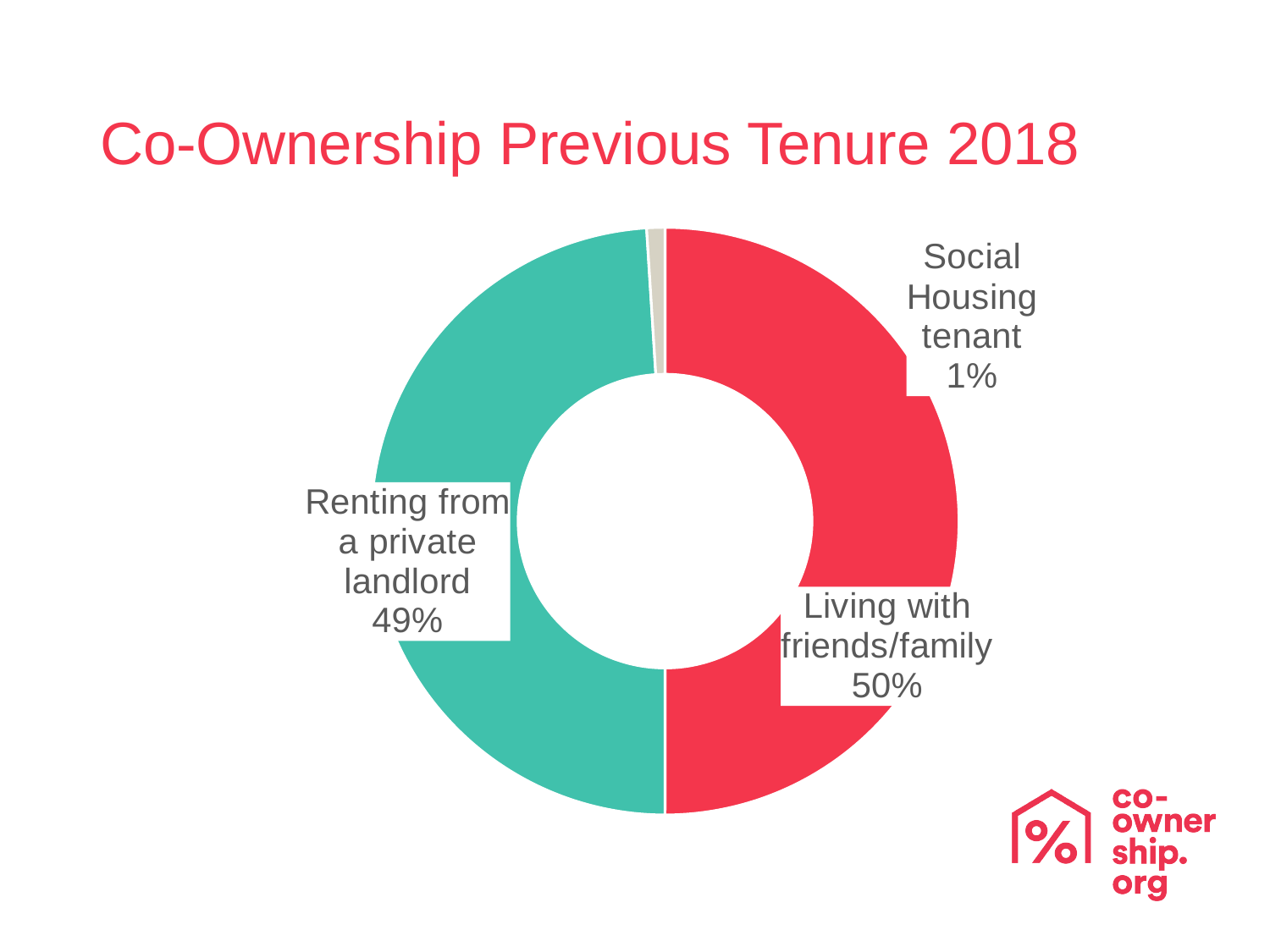
Which category has the smallest share? Social Housing tenant How many categories are shown in the chart? 3 What is the difference between the shares for 'Living with friends/family' and 'Renting from a private landlord'? 1% What share of the chart is 'Living with friends/family'? 50% What is the title of the chart? Co-Ownership Previous Tenure 2018 Which is larger: the share for 'Renting from a private landlord' or the share for 'Social Housing tenant'? Renting from a private landlord What is the difference between the shares for 'Renting from a private landlord' and 'Social Housing tenant'? 48% What share of the chart is 'Renting from a private landlord'? 49% What is the combined share of 'Living with friends/family' and 'Renting from a private landlord'? 99% What kind of chart is shown on the slide? Doughnut (pie) chart What share of the chart is 'Social Housing tenant'? 1% What colour is the 'Renting from a private landlord' segment? Green (teal)